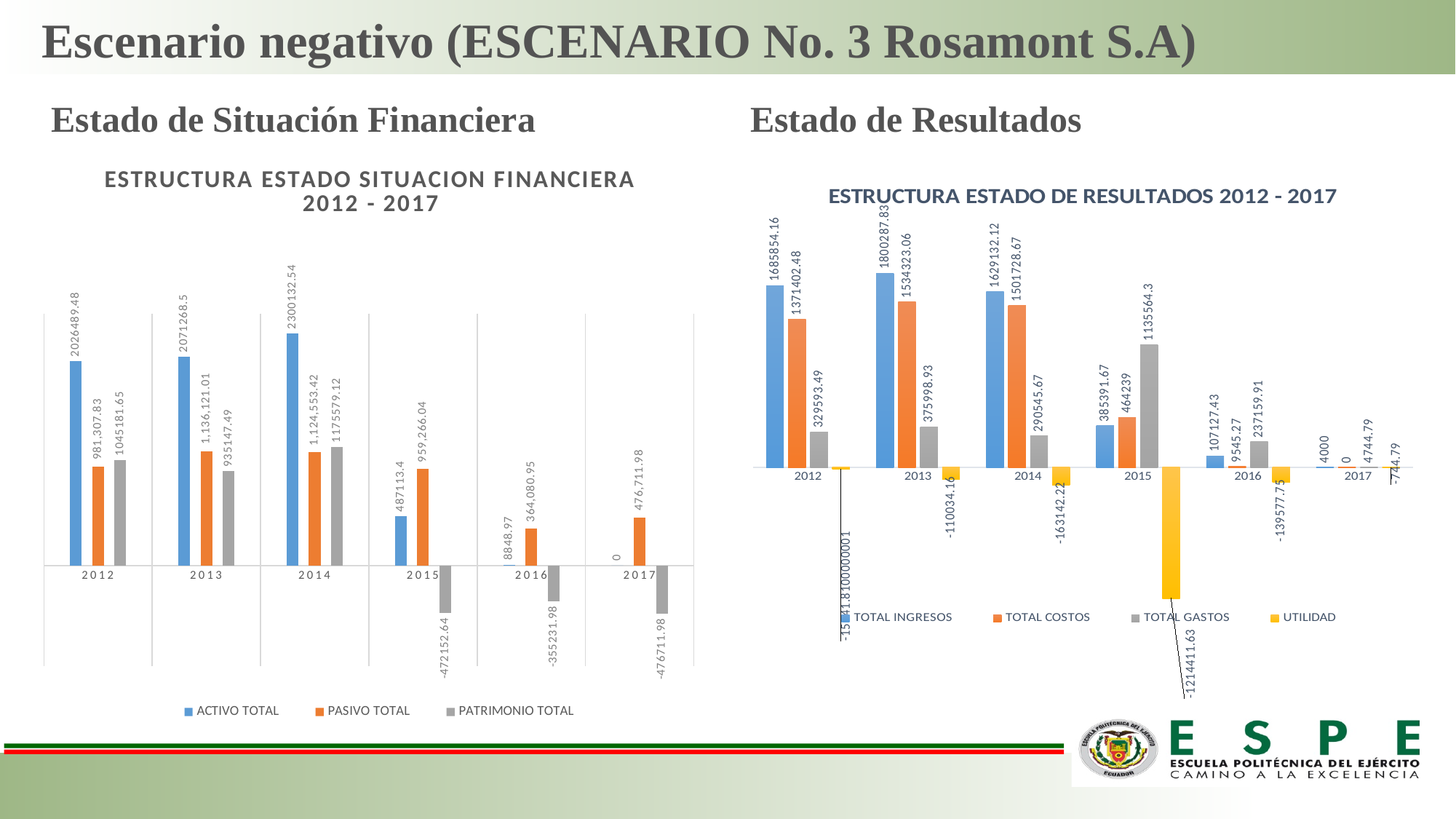
In the ESTRUCTURA ESTADO DE RESULTADOS chart, what is the UTILIDAD value for 2015? -1214411.63 In the ESTRUCTURA ESTADO DE RESULTADOS chart, what is the TOTAL INGRESOS value for 2013? 1800287.83 In the ESTRUCTURA ESTADO DE RESULTADOS chart, how many years are shown on the x axis? 6 In the ESTRUCTURA ESTADO SITUACION FINANCIERA chart, what is the PATRIMONIO TOTAL value for 2017? -476711.98 In the ESTRUCTURA ESTADO SITUACION FINANCIERA chart, is the PASIVO TOTAL for 2015 larger or smaller than the ACTIVO TOTAL for 2015? larger In the ESTRUCTURA ESTADO DE RESULTADOS chart, what is the TOTAL GASTOS value for 2016? 237159.91 In the ESTRUCTURA ESTADO SITUACION FINANCIERA chart, what is the ACTIVO TOTAL value for 2014? 2300132.54 In the ESTRUCTURA ESTADO SITUACION FINANCIERA chart, what is the PASIVO TOTAL value for 2013? 1,136,121.01 In the ESTRUCTURA ESTADO DE RESULTADOS chart, which year has the highest TOTAL GASTOS? 2015 In the ESTRUCTURA ESTADO SITUACION FINANCIERA chart, how many series does the legend list? 3 In the ESTRUCTURA ESTADO SITUACION FINANCIERA chart, which year has the highest ACTIVO TOTAL? 2014 What kind of chart is the ESTRUCTURA ESTADO DE RESULTADOS chart? bar chart